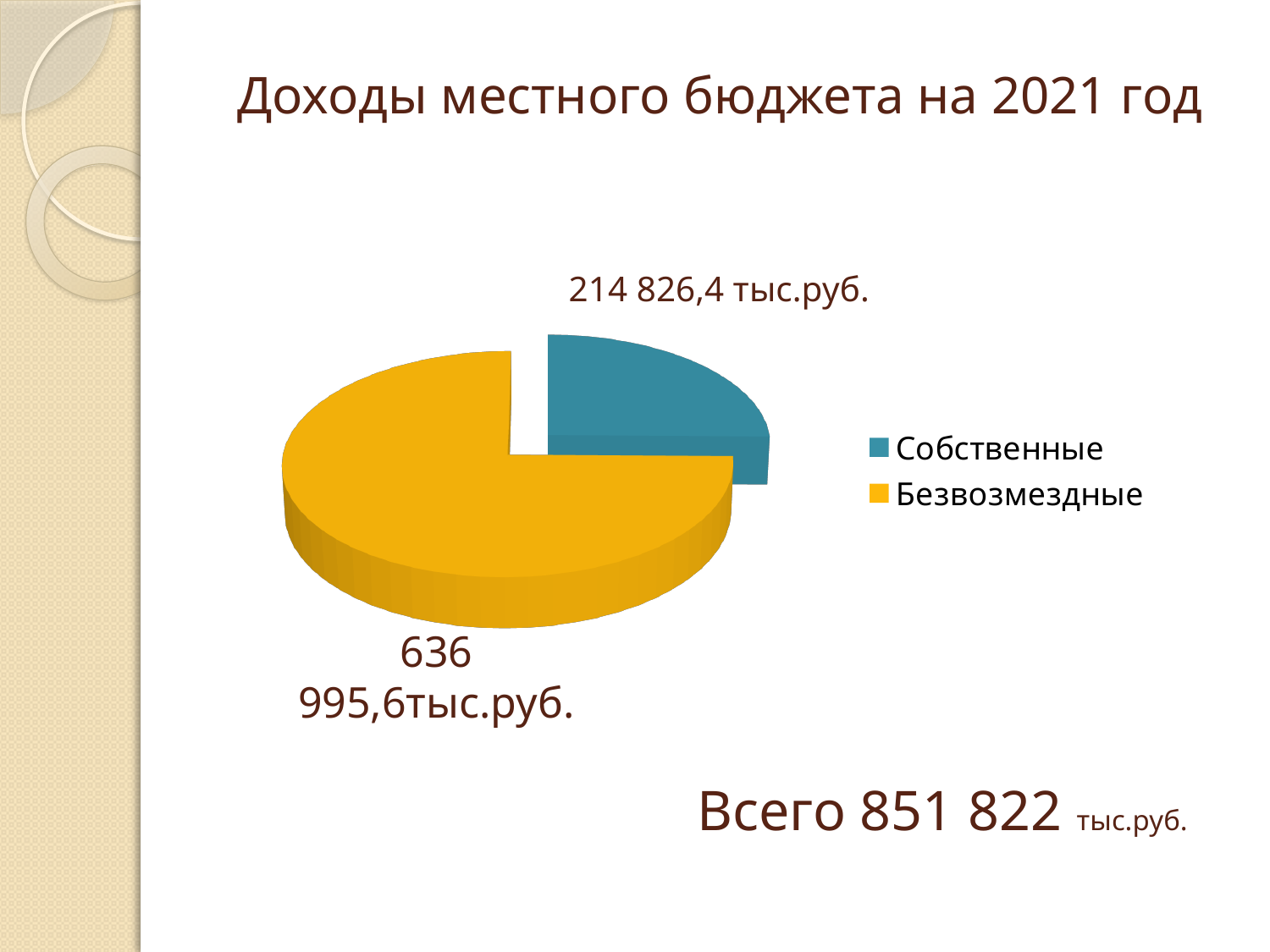
Which is larger, Собственные or Безвозмездные? Безвозмездные How many slices does the pie chart have? 2 What total is stated on the slide for the local budget revenues? 851 822 тыс.руб. What is the title of the slide? Доходы местного бюджета на 2021 год Which category has the smallest slice of the pie? Собственные What kind of chart is shown on the slide? Pie chart What colour is the Собственные slice? Blue How many entries does the legend list? 2 What is the value of the Собственные slice? 214 826,4 тыс.руб. What is the difference between the Безвозмездные and Собственные values? 422 169,2 тыс.руб. What is the value of the Безвозмездные slice? 636 995,6 тыс.руб. Which category has the largest slice of the pie? Безвозмездные